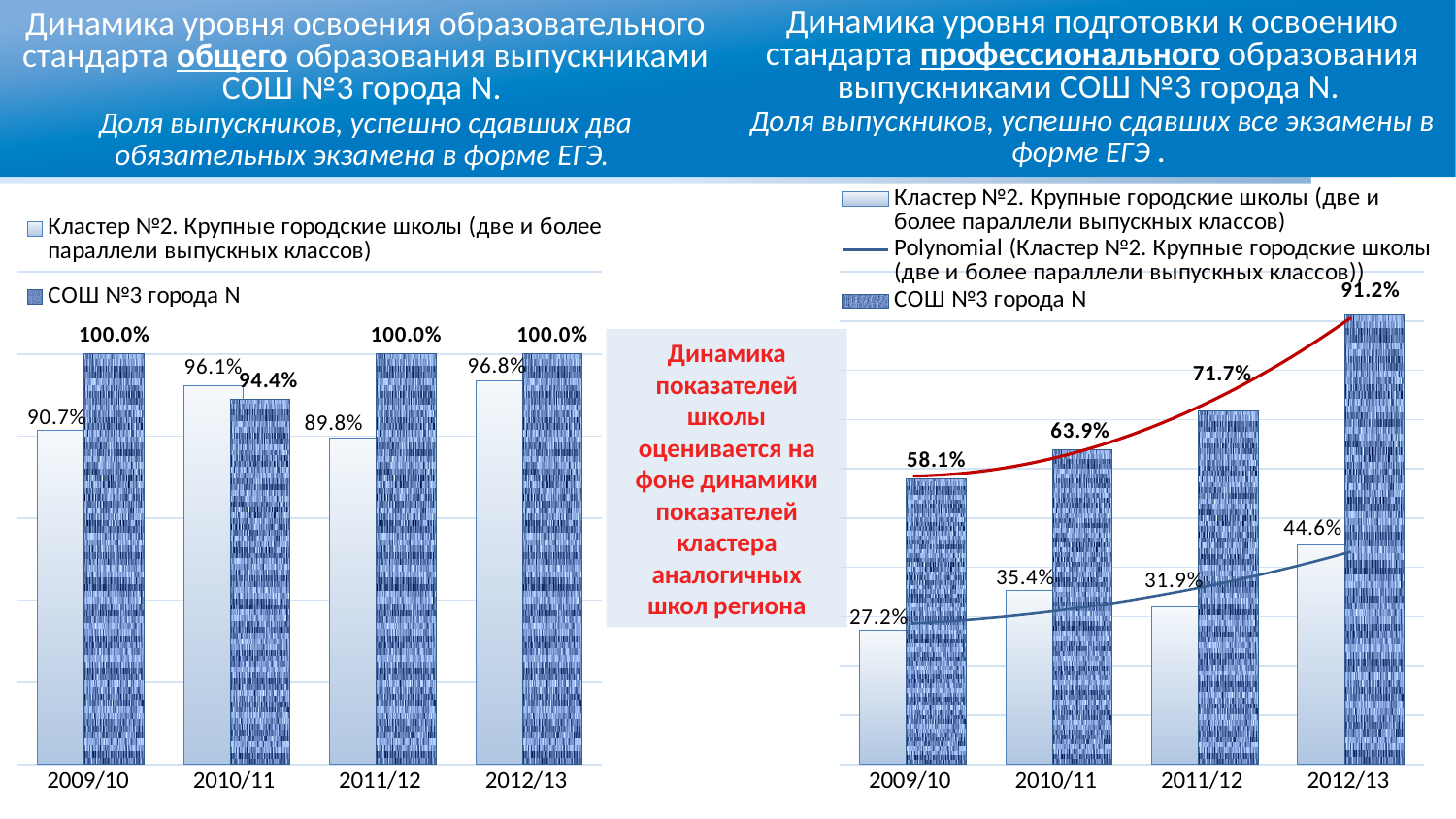
In the left chart, what is the value for Кластер №2 in 2011/12? 89.8% What type of chart is the left chart? bar chart How many entries does the legend of the right chart list? 3 In the right chart, what is the difference between СОШ №3 города N and Кластер №2 in 2012/13? 46.6% In the right chart, what is the value for СОШ №3 города N in 2012/13? 91.2% In the right chart, do the values for СОШ №3 города N rise or fall from 2009/10 to 2012/13? rise In the left chart, how many years are shown on the x axis? 4 In the right chart, in which year is the value for СОШ №3 города N the lowest? 2009/10 In the right chart, in which year is the value for Кластер №2 the highest? 2012/13 In the left chart, what is the value for СОШ №3 города N in 2009/10? 100.0% In the right chart, what is the value for Кластер №2 in 2009/10? 27.2% In the left chart, which is larger in 2010/11: Кластер №2 or СОШ №3 города N? Кластер №2